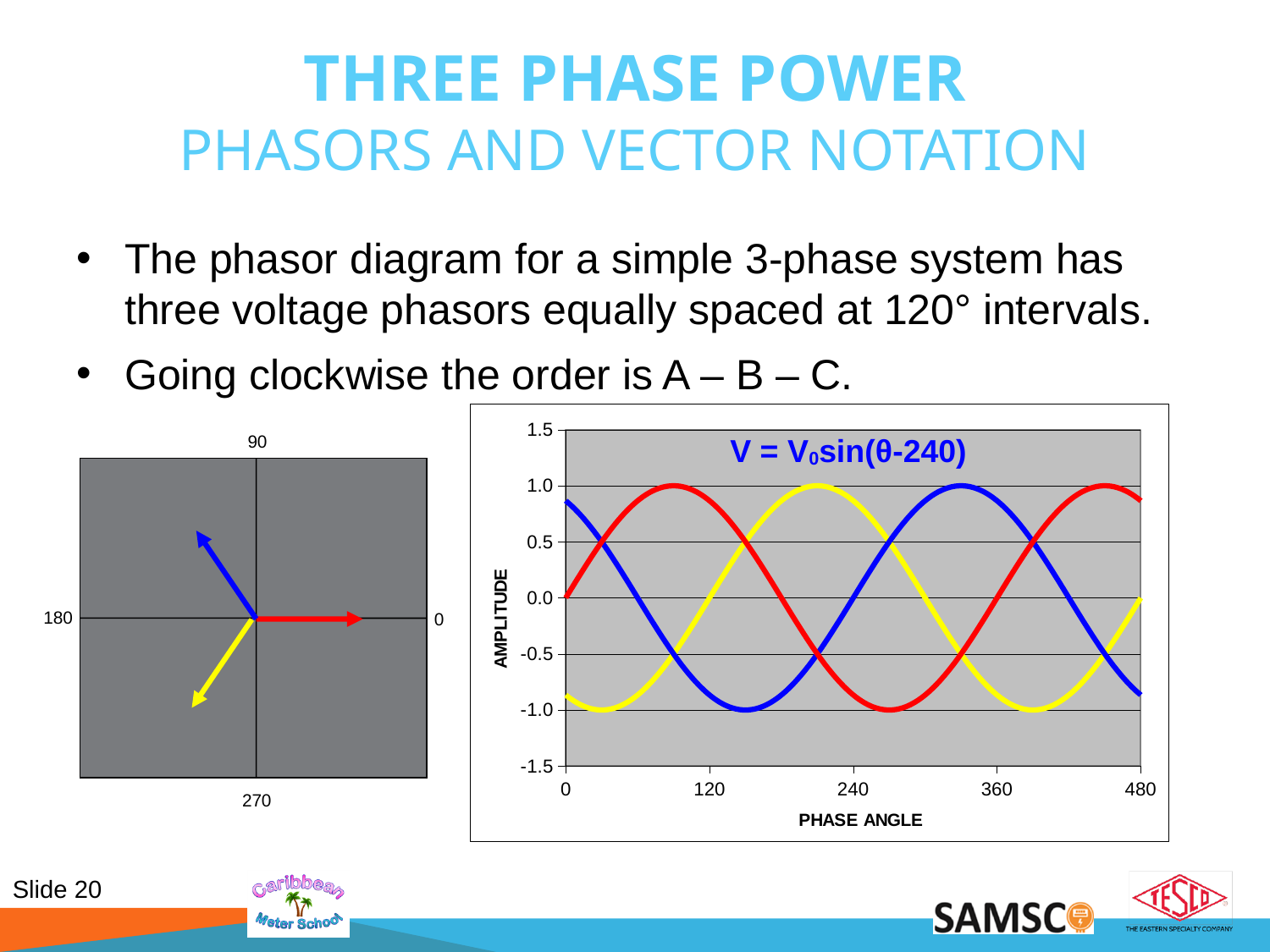
In the line chart on the right, what is the value of the blue line at a phase angle of 240? 0.0 In the line chart on the right, what is the value of the red line at a phase angle of 0? 0.0 In the phasor diagram on the left, how many arrows are drawn? 3 In the line chart on the right, what is the value of the red line at a phase angle of 360? 0.0 In the line chart on the right, what is the title of the y axis? AMPLITUDE In the line chart on the right, how many lines are plotted? 3 What kind of chart is the chart on the right of the slide? line chart In the line chart on the right, what is the title of the x axis? PHASE ANGLE In the line chart on the right, is the value of the blue line at a phase angle of 0 greater or less than 0.5? greater In the line chart on the right, at a phase angle of 120, which line has the larger value, the red line or the blue line? red line In the line chart on the right, is the value of the red line at a phase angle of 240 greater or less than -0.5? less In the line chart on the right, is the value of the yellow line at a phase angle of 0 greater or less than -0.5? less